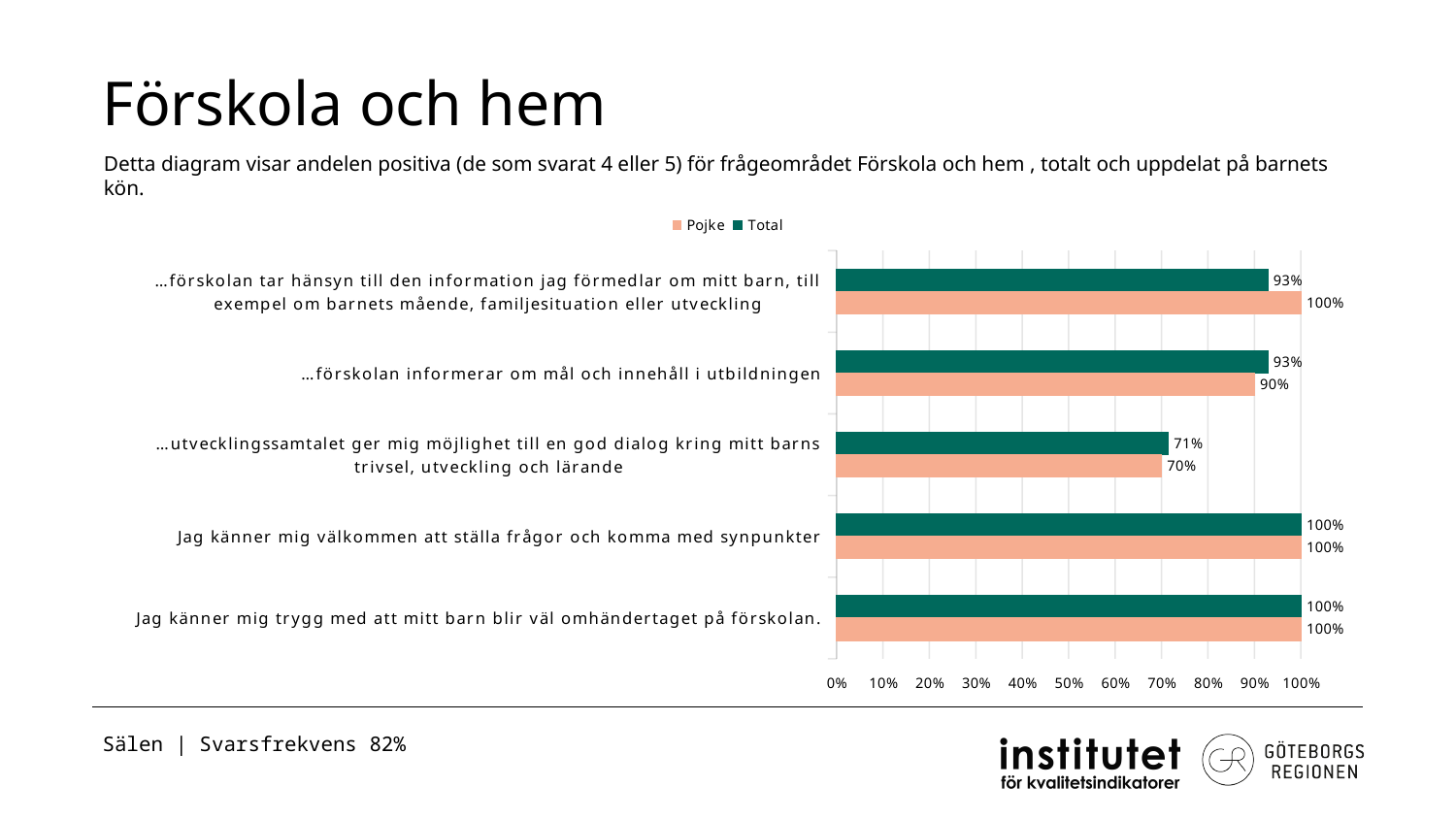
How many categories are shown in the chart? 5 What is the Pojke value for "…förskolan informerar om mål och innehåll i utbildningen"? 90% What kind of chart is shown on the slide? Bar chart What is the difference between the Pojke and Total values for "…förskolan tar hänsyn till den information jag förmedlar om mitt barn, till exempel om barnets mående, familjesituation eller utveckling"? 7% What is the Total value for "Jag känner mig trygg med att mitt barn blir väl omhändertaget på förskolan."? 100% How many series does the legend list? 2 What is the Pojke value for "…utvecklingssamtalet ger mig möjlighet till en god dialog kring mitt barns trivsel, utveckling och lärande"? 70% Which series is shown in dark green in the legend? Total What is the Total value for "…förskolan tar hänsyn till den information jag förmedlar om mitt barn, till exempel om barnets mående, familjesituation eller utveckling"? 93% Which category has the lowest Total value? …utvecklingssamtalet ger mig möjlighet till en god dialog kring mitt barns trivsel, utveckling och lärande What is the Total value for "…förskolan informerar om mål och innehåll i utbildningen"? 93% For "…förskolan informerar om mål och innehåll i utbildningen", which is larger, the Pojke value or the Total value? Total